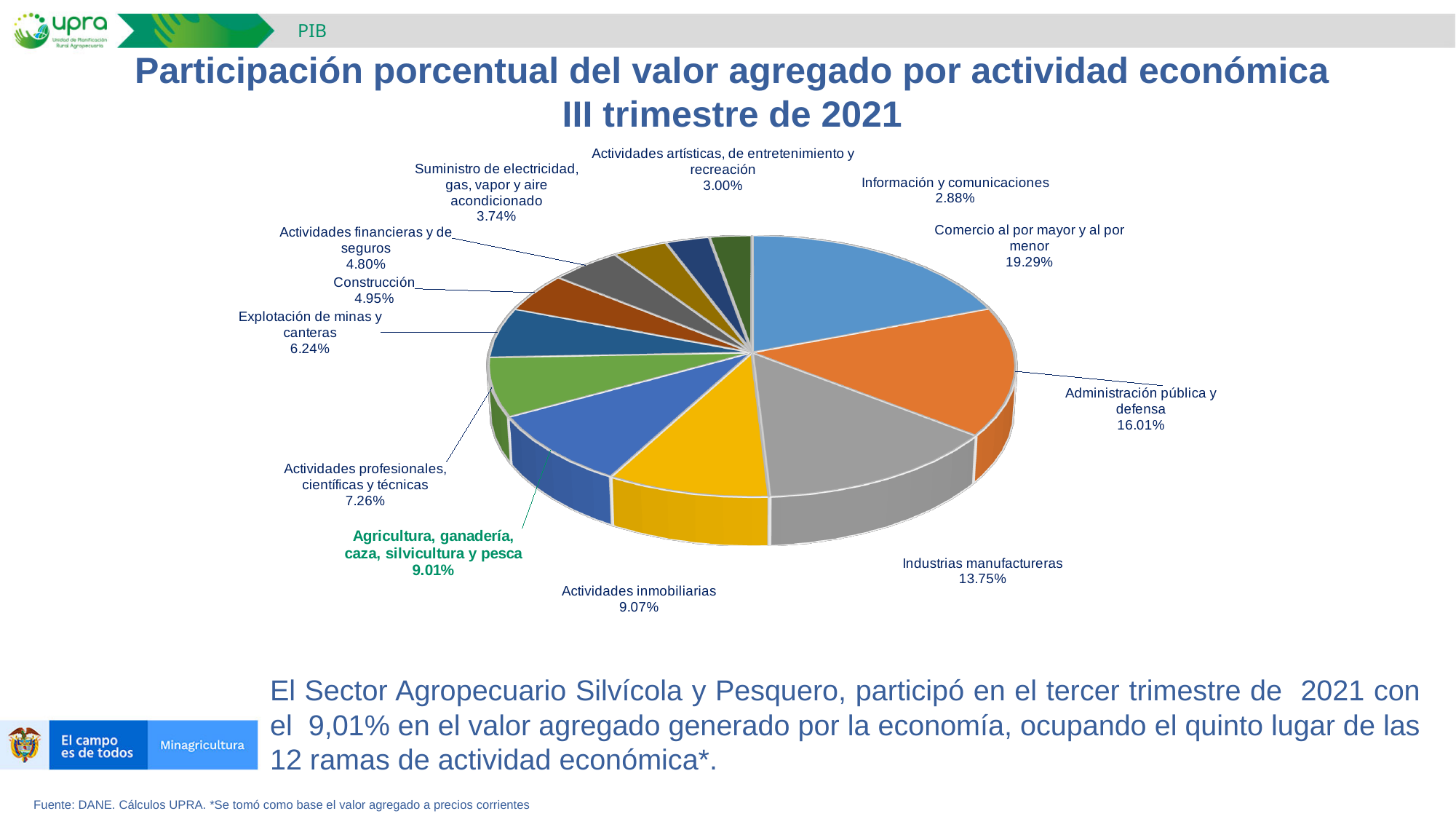
Which economic activity has the smallest share of the pie? Información y comunicaciones What kind of chart is shown on the slide? Pie chart What is the difference in percentage points between Comercio al por mayor y al por menor and Administración pública y defensa? 3.28% Which is larger, Construcción or Actividades financieras y de seguros? Construcción How many economic activities (slices) are shown in the pie chart? 12 Which economic activity has the largest share of the pie? Comercio al por mayor y al por menor What is the value shown for Industrias manufactureras? 13.75% What is the title of the chart? Participación porcentual del valor agregado por actividad económica III trimestre de 2021 What is the difference between Actividades inmobiliarias and Agricultura, ganadería, caza, silvicultura y pesca? 0.06% What share of the pie does Comercio al por mayor y al por menor represent? 19.29% What is the value shown for Explotación de minas y canteras? 6.24% What is the value shown for Agricultura, ganadería, caza, silvicultura y pesca? 9.01%